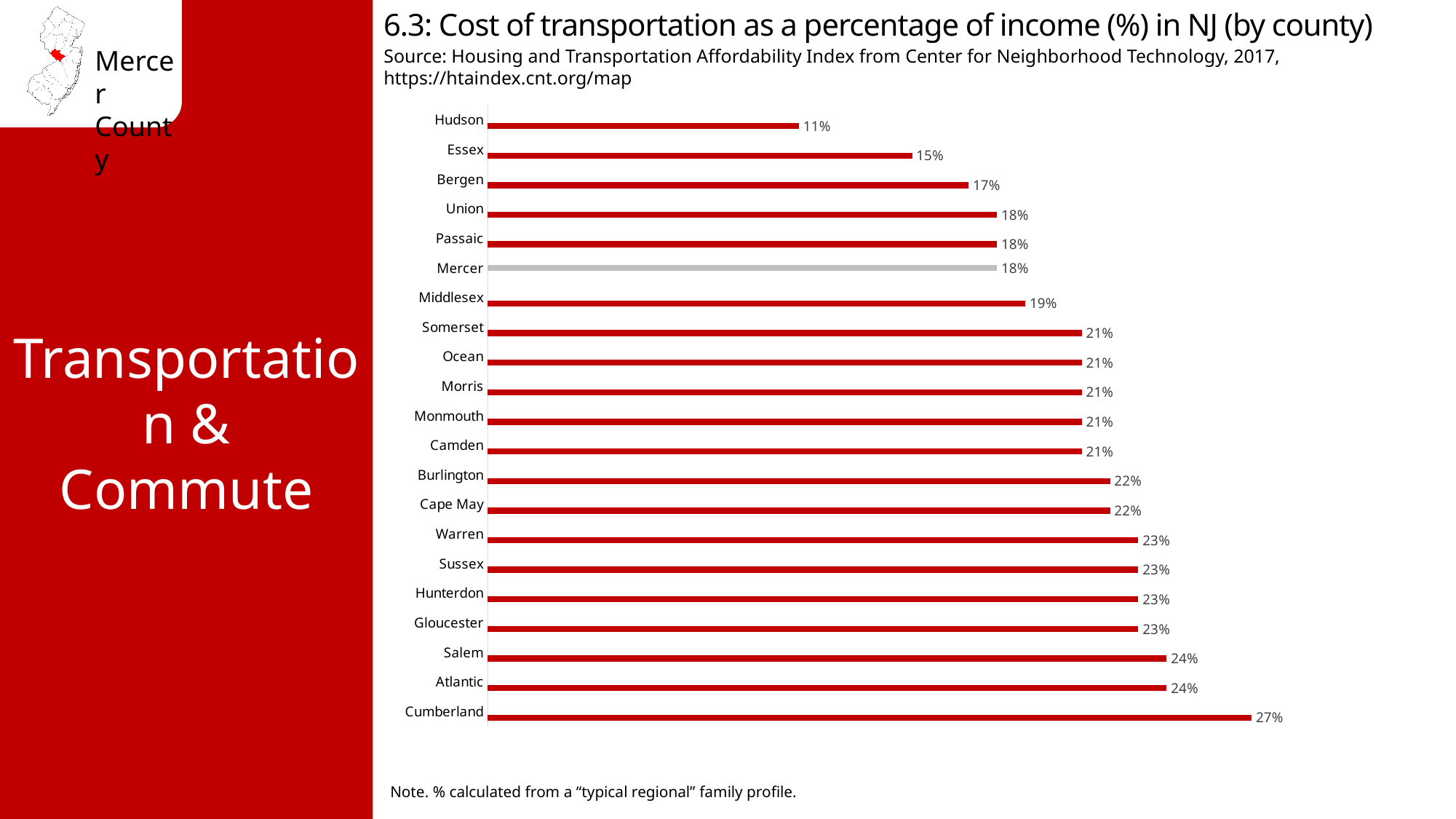
What is the value shown for Cumberland County? 27% Which county has the lowest cost of transportation as a percentage of income? Hudson What kind of chart is shown on the slide? Bar chart What is the value shown for Hudson County? 11% Which has a higher value, Salem or Warren? Salem Which county has the highest cost of transportation as a percentage of income? Cumberland Which county's bar is shown in grey rather than red? Mercer What is the difference between the values for Mercer and Middlesex? 1% How many counties are shown in the chart? 21 Which has a higher value, Essex or Bergen? Bergen What is the cost of transportation as a percentage of income for Mercer County? 18% What is the difference between the values for Cumberland and Hudson? 16%